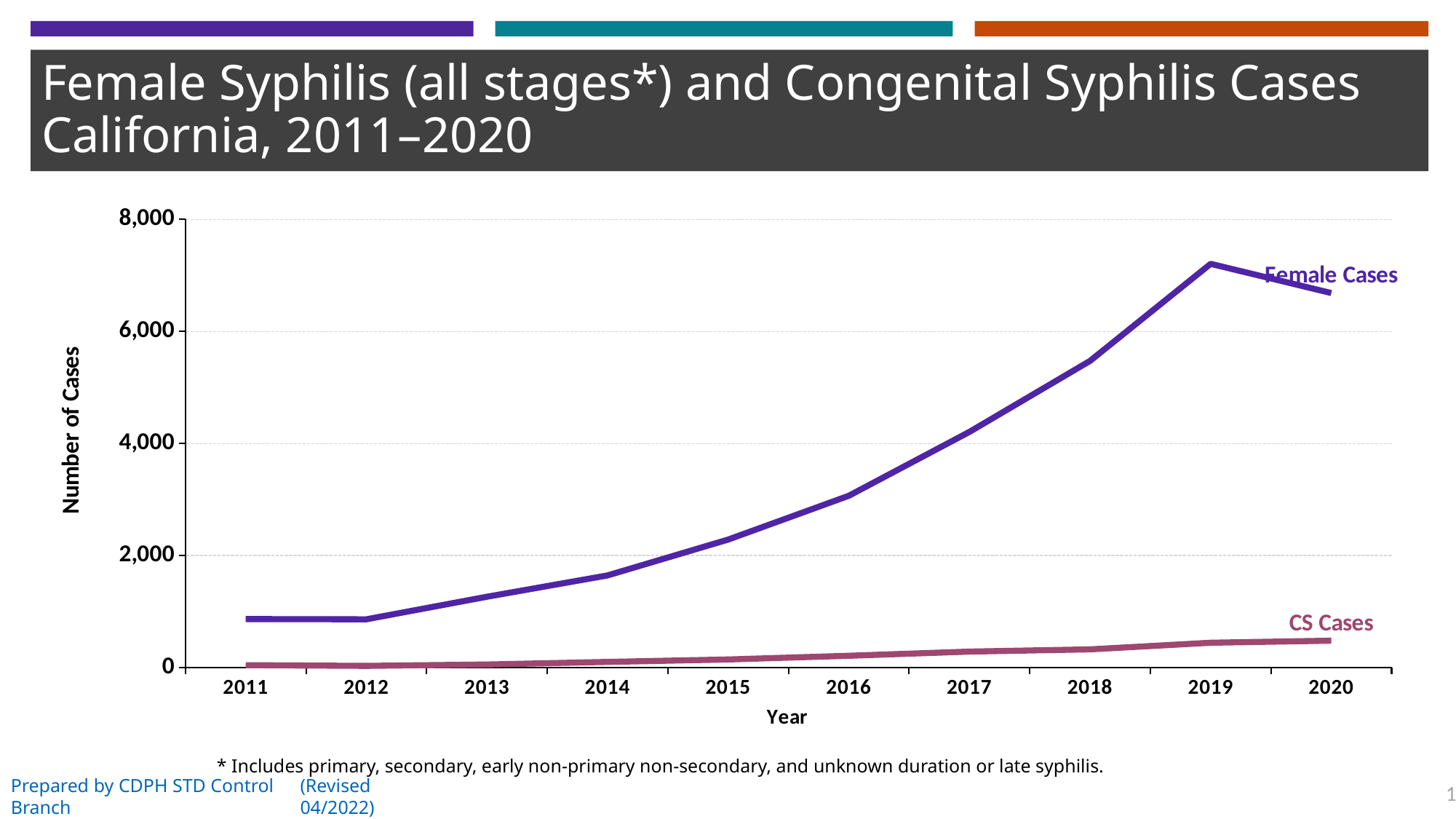
Is the value for Female Cases in 2016 greater or less than 2,000? greater Do CS Cases generally rise or fall from 2011 to 2020? rise What is the label on the y axis of the chart? Number of Cases Is the value for Female Cases in 2019 greater or less than 6,000? greater Which series has the higher value in 2020, Female Cases or CS Cases? Female Cases Which is larger, Female Cases in 2019 or Female Cases in 2020? Female Cases in 2019 Is the value for CS Cases in 2020 greater or less than 2,000? less What kind of chart is shown on the slide? line chart How many series are plotted on the chart? 2 How many years are shown along the x axis? 10 In which year do Female Cases reach their highest value? 2019